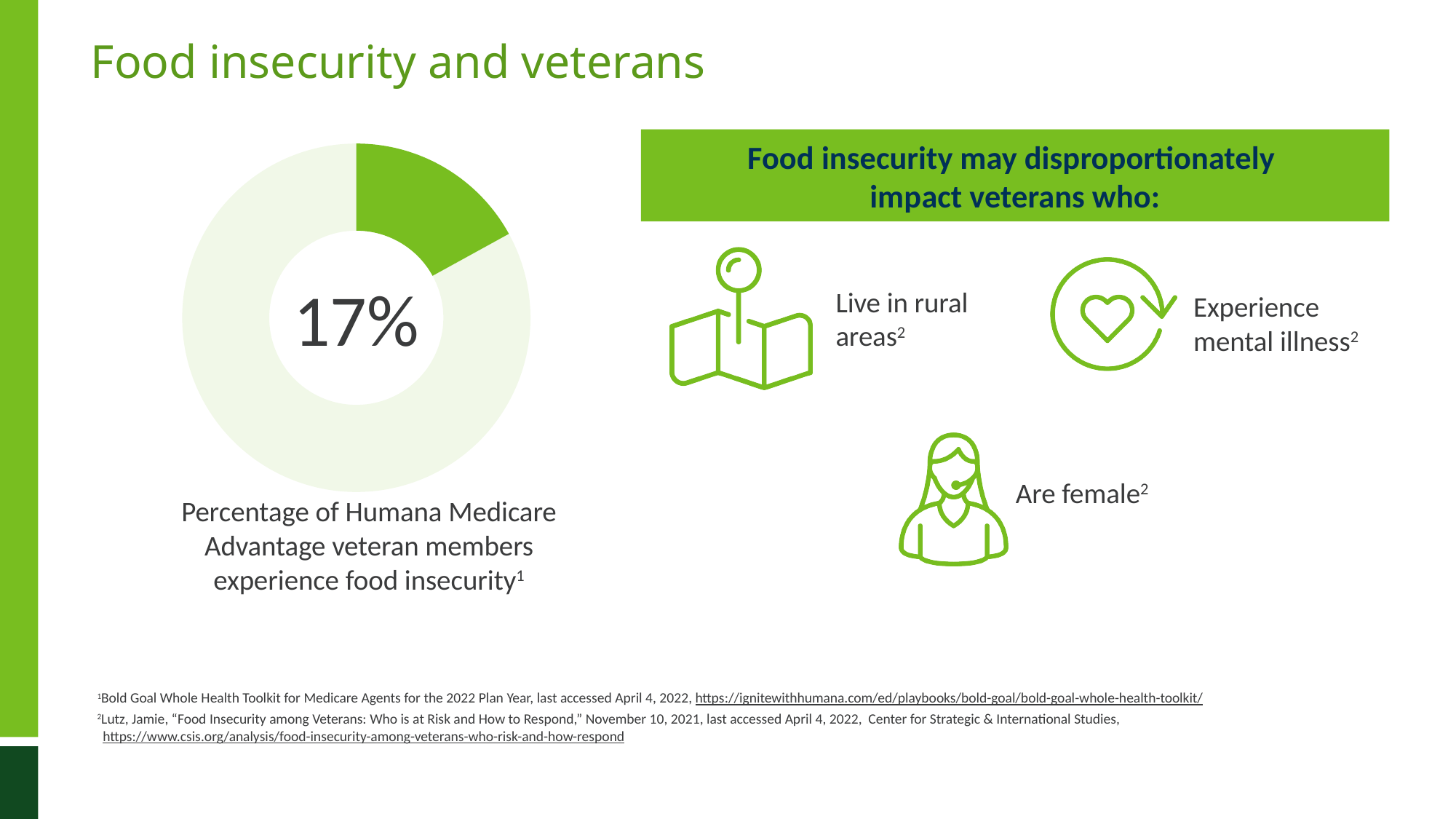
Which slice of the donut chart is larger, the dark green slice or the light green slice? The light green slice What does the 17% in the donut chart represent? Percentage of Humana Medicare Advantage veteran members experience food insecurity What kind of chart is shown on the left of the slide? Donut (pie) chart What percentage is shown in the centre of the donut chart? 17% Is the value shown in the donut chart greater or less than 20%? less What colour is the slice representing the 17% in the donut chart? Dark green How many slices does the donut chart have? 2 Is the highlighted (dark green) slice of the donut chart greater or less than 50% of the whole? less